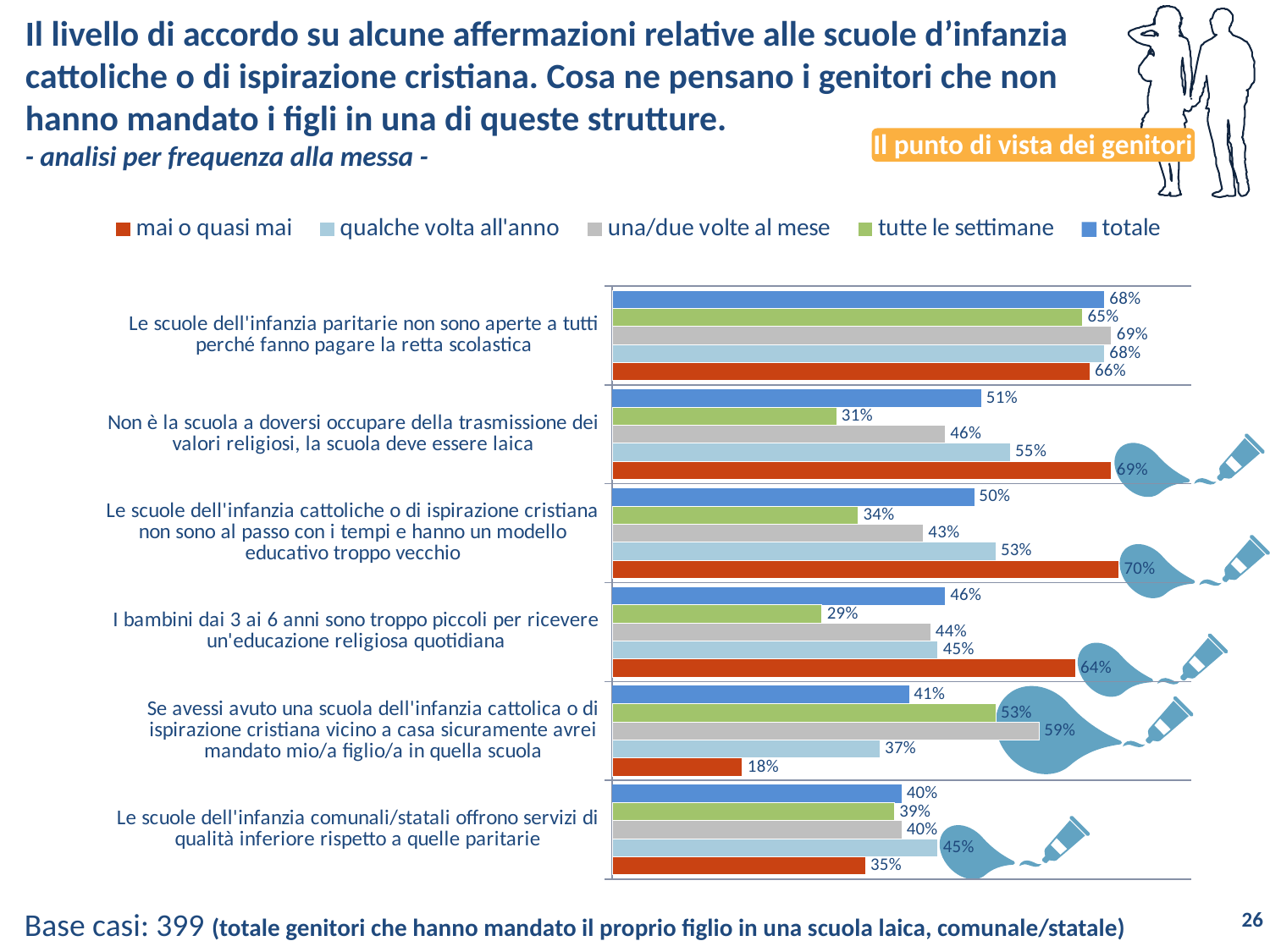
For the statement 'I bambini dai 3 ai 6 anni sono troppo piccoli per ricevere un'educazione religiosa quotidiana', which is larger: the 'una/due volte al mese' value or the 'qualche volta all'anno' value? qualche volta all'anno What is the 'tutte le settimane' value for the statement 'Se avessi avuto una scuola dell'infanzia cattolica o di ispirazione cristiana vicino a casa sicuramente avrei mandato mio/a figlio/a in quella scuola'? 53% What is the 'mai o quasi mai' value for the statement 'Le scuole dell'infanzia cattoliche o di ispirazione cristiana non sono al passo con i tempi e hanno un modello educativo troppo vecchio'? 70% What kind of chart is shown on the slide? bar chart What is the 'qualche volta all'anno' value for the statement 'Le scuole dell'infanzia comunali/statali offrono servizi di qualità inferiore rispetto a quelle paritarie'? 45% What is the 'totale' value for the statement 'Le scuole dell'infanzia paritarie non sono aperte a tutti perché fanno pagare la retta scolastica'? 68% How many series does the legend list? 5 Which statement has the highest 'totale' value? Le scuole dell'infanzia paritarie non sono aperte a tutti perché fanno pagare la retta scolastica How many statements (categories) are plotted in the chart? 6 Which statement has the lowest 'mai o quasi mai' value? Se avessi avuto una scuola dell'infanzia cattolica o di ispirazione cristiana vicino a casa sicuramente avrei mandato mio/a figlio/a in quella scuola For the statement 'Non è la scuola a doversi occupare della trasmissione dei valori religiosi, la scuola deve essere laica', what is the difference between the 'mai o quasi mai' value and the 'tutte le settimane' value? 38% Which series in the legend is shown in red? mai o quasi mai